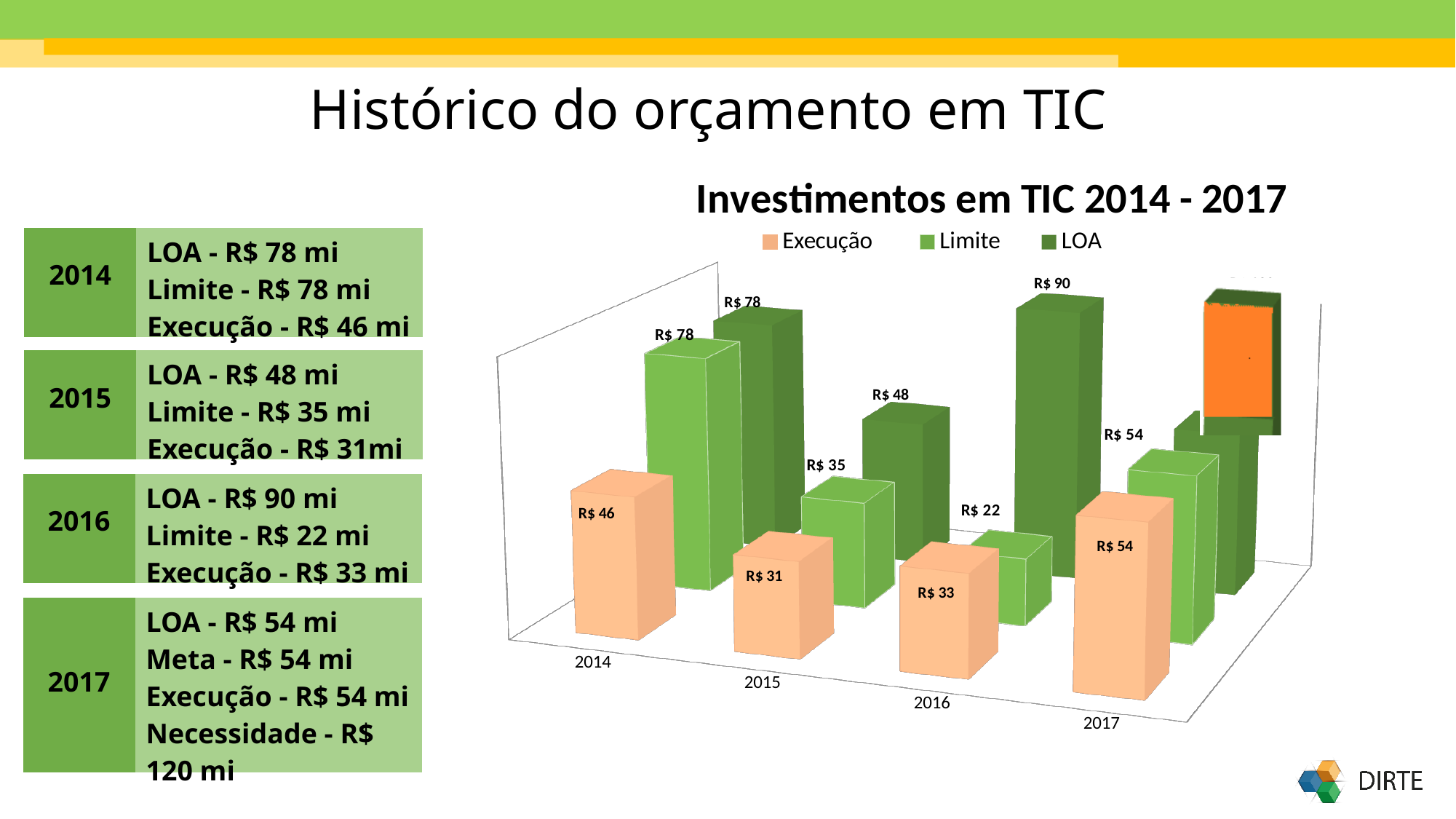
Does the Execução series rise or fall from 2016 to 2017? rise Which year has the highest LOA value in the chart? 2016 What is the Limite value for 2015 in the chart? R$ 35 What is the title of the chart? Investimentos em TIC 2014 - 2017 How many series does the chart legend list? 3 What is the Execução value for 2014 in the chart? R$ 46 What is the difference between the LOA and Execução values for 2016? R$ 57 What is the LOA value for 2016 in the chart? R$ 90 How many years are shown on the x axis of the chart? 4 Which year has the lowest Limite value in the chart? 2016 Which is larger in 2015, the LOA value or the Execução value? LOA What type of chart is shown on the slide? bar chart